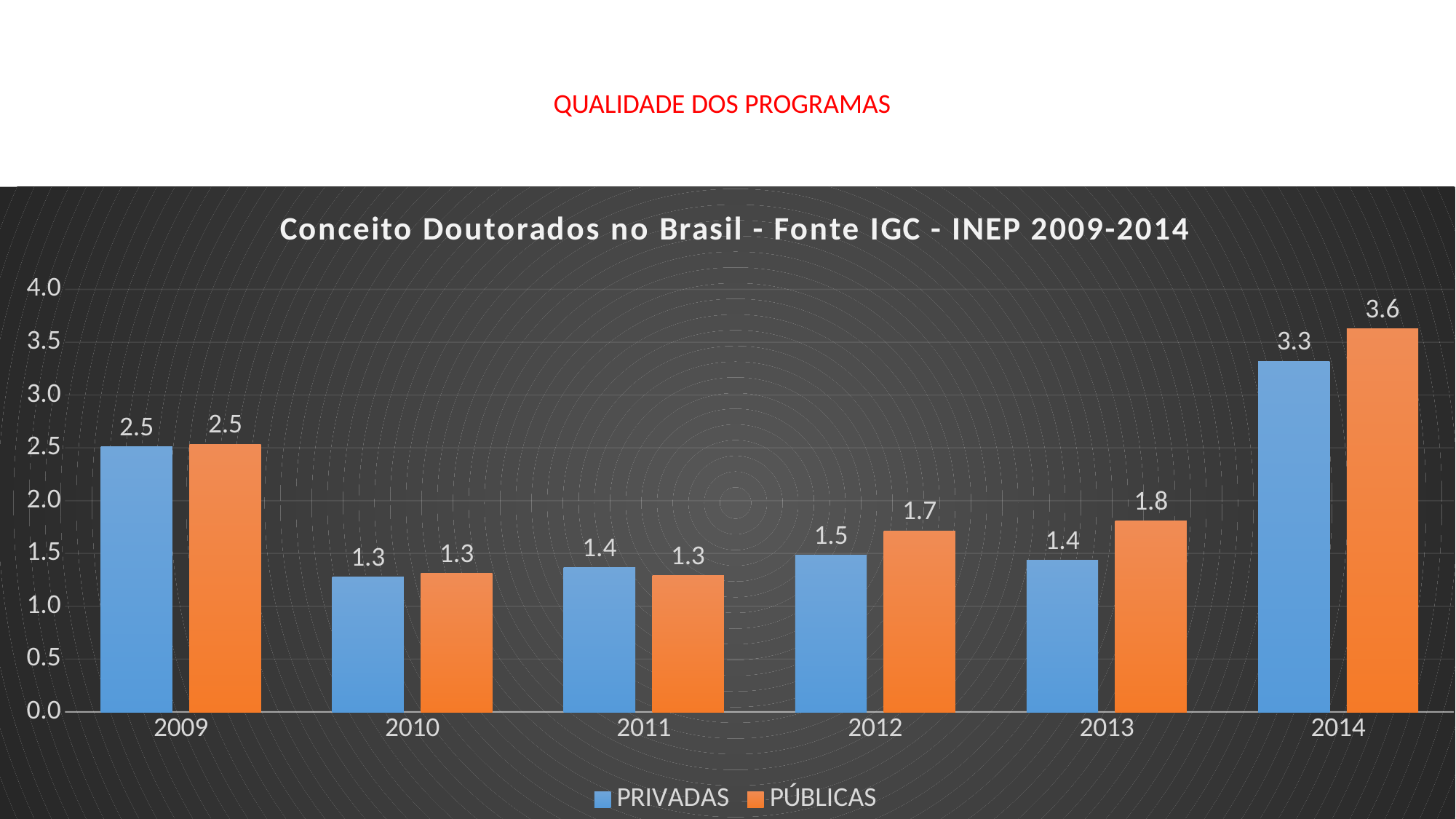
What is the value for PRIVADAS in 2014? 3.3 In 2012, which series has the larger value, PRIVADAS or PÚBLICAS? PÚBLICAS Is the value for PRIVADAS in 2009 greater or less than 2.0? greater What is the title of the chart? Conceito Doutorados no Brasil - Fonte IGC - INEP 2009-2014 Which year has the lowest value for PRIVADAS? 2010 Which year has the highest value for PÚBLICAS? 2014 How many years are shown on the x axis? 6 What is the difference between the PÚBLICAS and PRIVADAS values in 2014? 0.3 What is the value for PÚBLICAS in 2012? 1.7 What kind of chart is shown on the slide? Bar chart How many series does the legend list? 2 What is the value for PÚBLICAS in 2013? 1.8